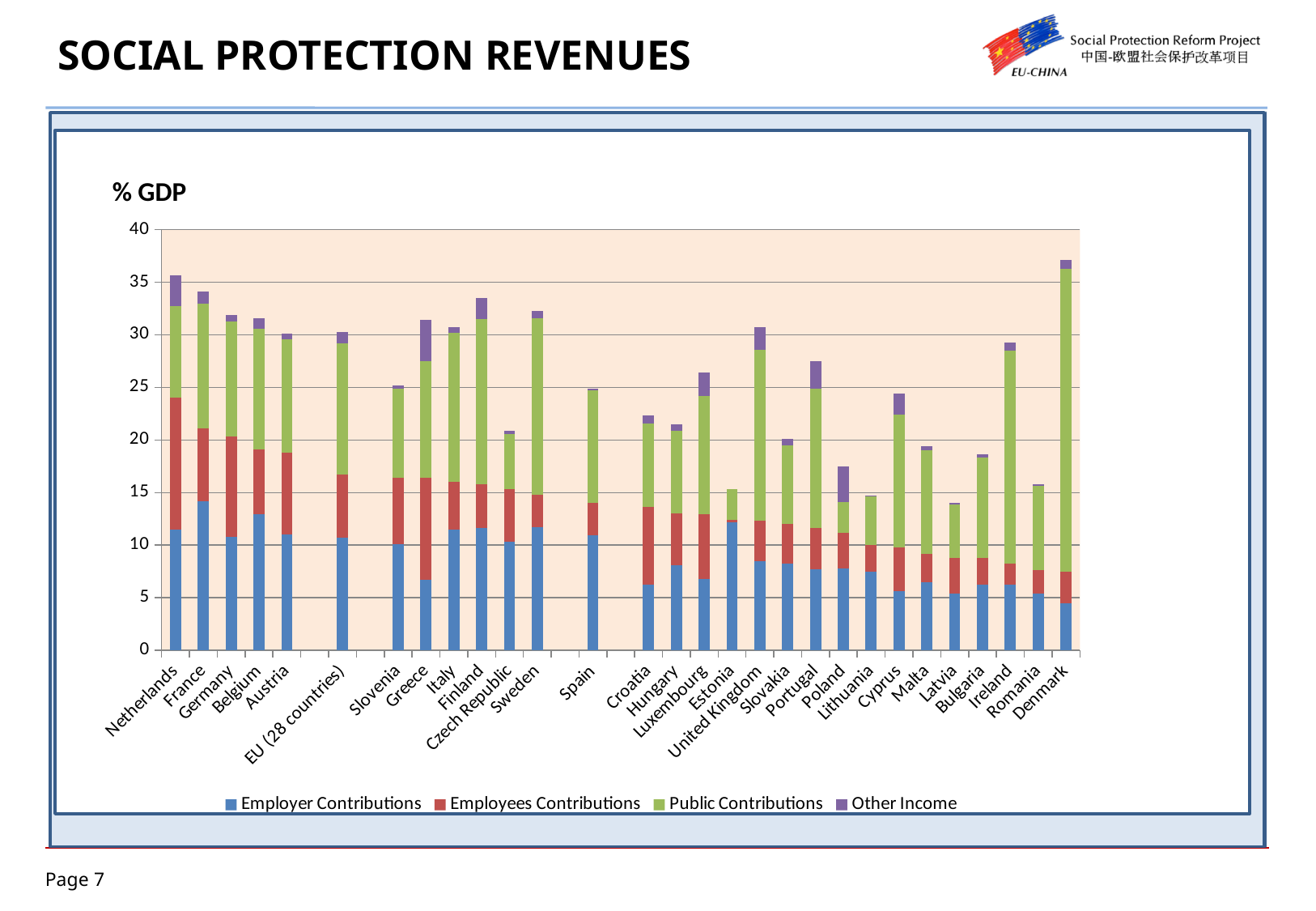
Which country has the largest Employees Contributions segment? Netherlands How many series does the legend list? 4 How many countries/categories are shown on the x axis? 29 Is the Employer Contributions value for Denmark greater or less than 5? less Is the total value for Estonia greater or less than 20? less What unit is shown as the label above the y axis? % GDP What kind of chart is shown on the slide? Stacked bar chart Which country has the largest Employer Contributions segment? France Which has a higher total, Netherlands or France? Netherlands Is the total value for Denmark greater or less than 35? greater Which country has the highest total social protection revenues as % of GDP? Denmark Which has a higher total, the United Kingdom or Portugal? United Kingdom